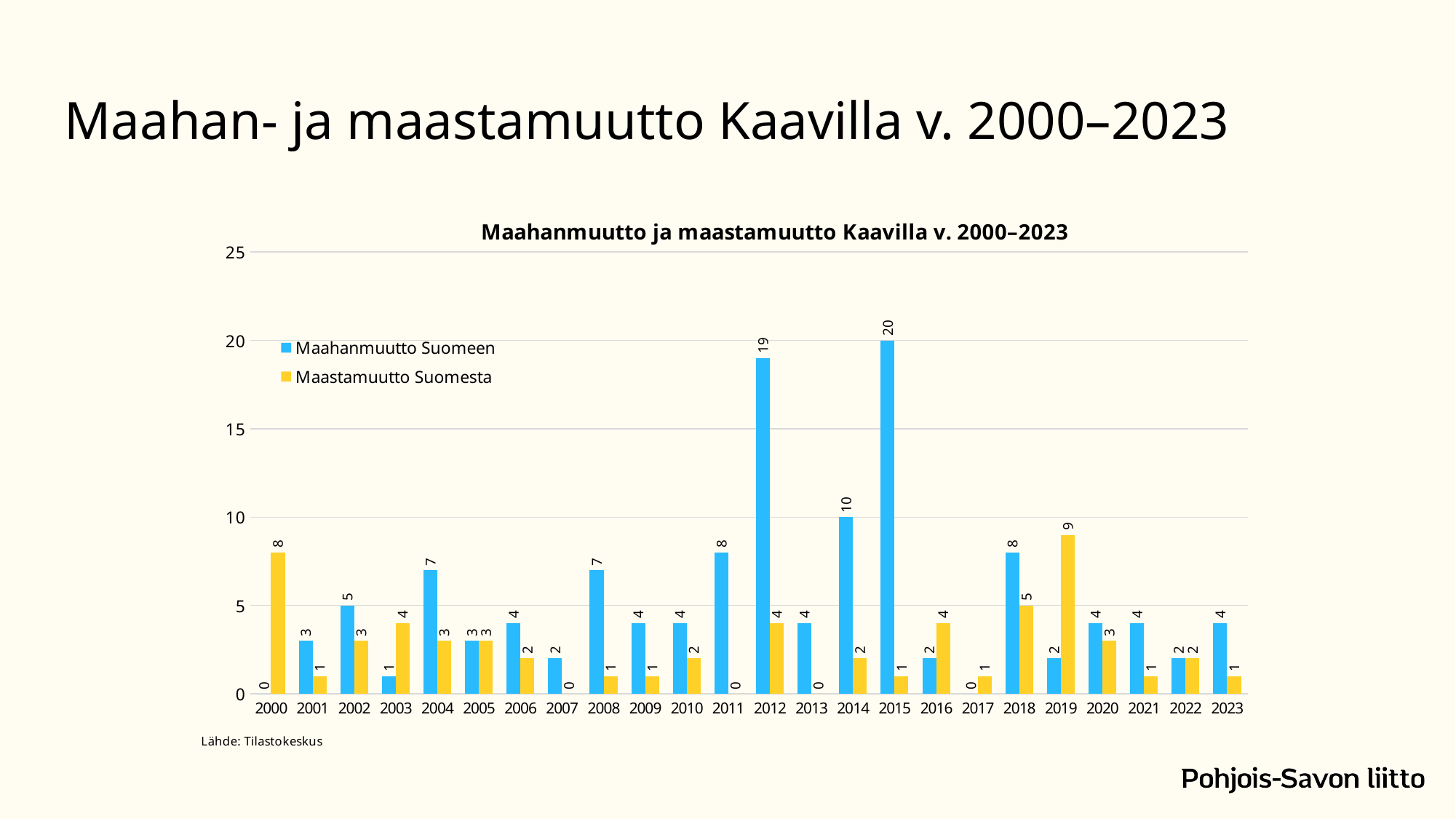
What kind of chart is shown on the slide? Bar chart In which year is Maahanmuutto Suomeen highest? 2015 In which year is Maastamuutto Suomesta highest? 2019 Is the value of Maahanmuutto Suomeen in 2012 greater or less than 15? greater What is the value of Maahanmuutto Suomeen in 2012? 19 How many years are shown on the x axis of the chart? 24 What is the difference between Maahanmuutto Suomeen and Maastamuutto Suomesta in 2014? 8 What is the value of Maastamuutto Suomesta in 2019? 9 What is the value of Maahanmuutto Suomeen in 2015? 20 Which is larger in 2018, Maahanmuutto Suomeen or Maastamuutto Suomesta? Maahanmuutto Suomeen What is the value of Maastamuutto Suomesta in 2000? 8 How many series does the legend list? 2